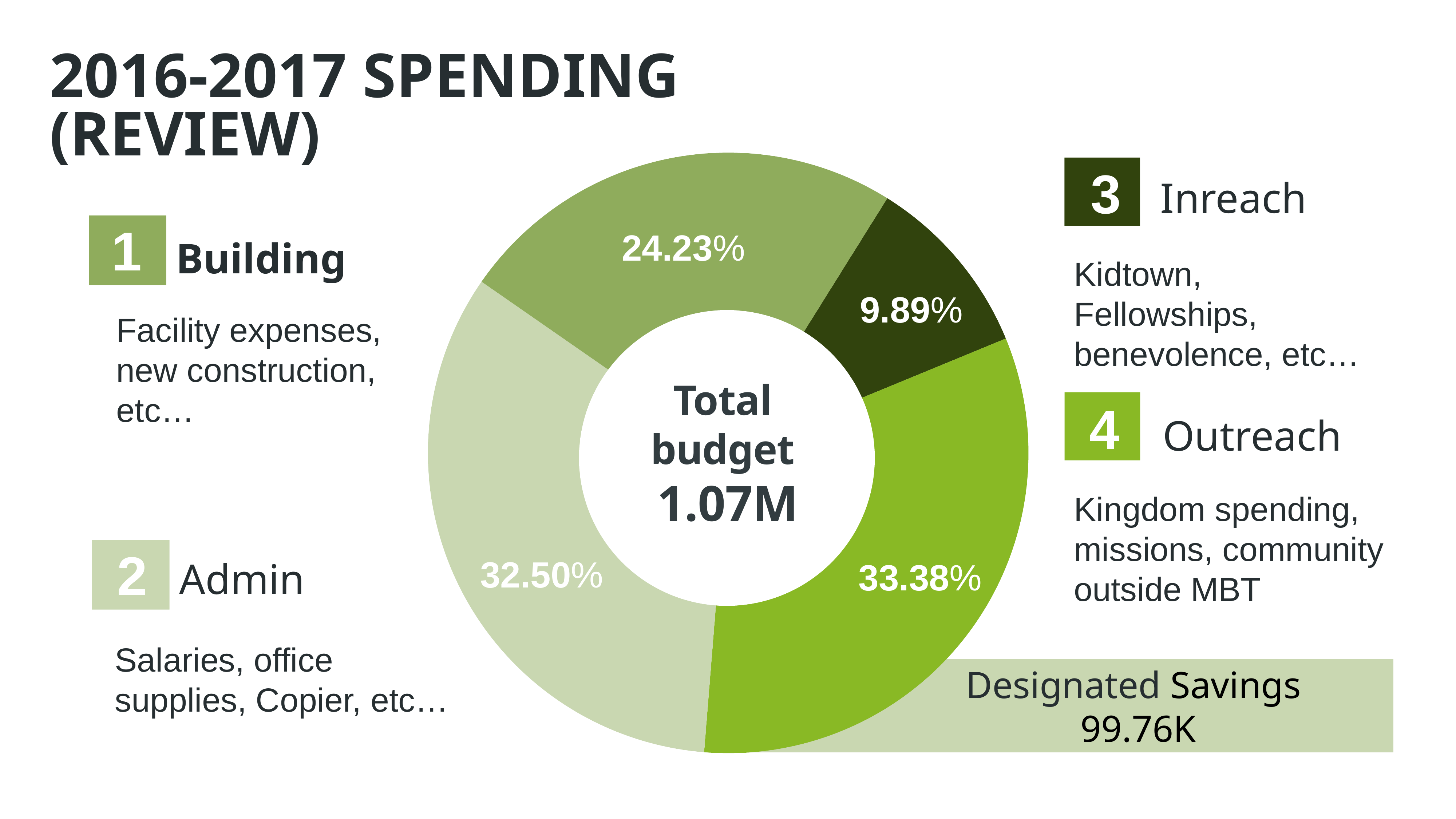
Which has a larger share of spending, Admin or Building? Admin How many spending categories are shown in the chart? 4 What total budget is shown in the centre of the chart? 1.07M What share of the 2016-2017 spending went to Building? 24.23% What is the difference in percentage points between the Building share and the Inreach share? 14.34% What share of the 2016-2017 spending went to Admin? 32.50% Which spending category has the smallest share of the budget? Inreach What is the difference in percentage points between the Outreach share and the Admin share? 0.88% What kind of chart is used to show the 2016-2017 spending? Pie (donut) chart What share of the 2016-2017 spending went to Inreach? 9.89% What share of the 2016-2017 spending went to Outreach? 33.38% Which spending category has the largest share of the budget? Outreach